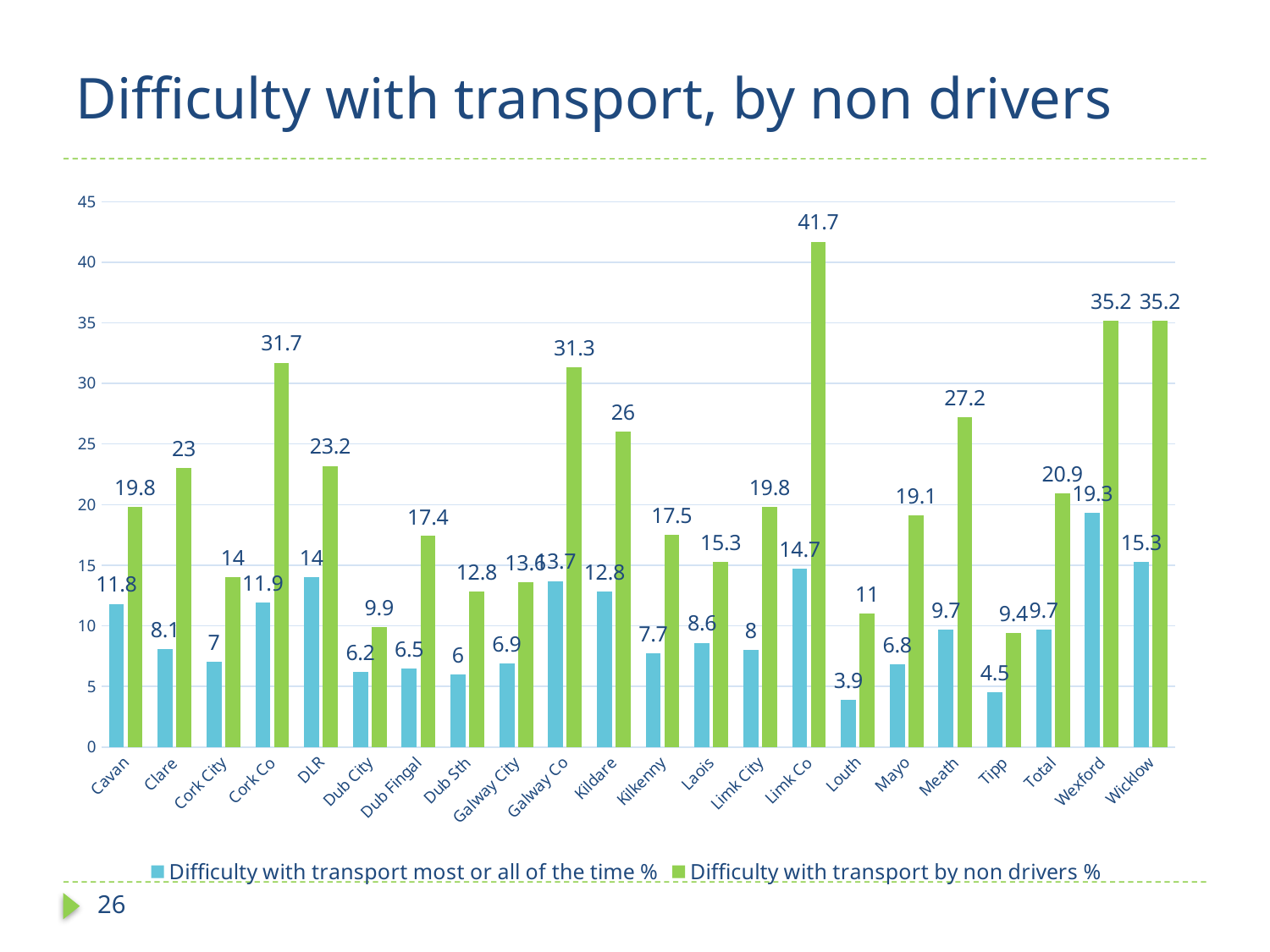
How many categories are shown on the x axis? 22 How many series does the legend list? 2 What is the value of 'Difficulty with transport most or all of the time %' for Louth? 3.9 What is the difference between the two series' values for Total? 11.2 What type of chart is shown on the slide? bar chart What is the title of the chart? Difficulty with transport, by non drivers Which is larger: 'Difficulty with transport by non drivers %' for Meath or for Kildare? Meath Which category has the highest value for 'Difficulty with transport by non drivers %'? Limk Co Which category has the lowest value for 'Difficulty with transport most or all of the time %'? Louth What is the value of 'Difficulty with transport by non drivers %' for Cork Co? 31.7 Which category has the highest value for 'Difficulty with transport most or all of the time %'? Wexford What is the value of 'Difficulty with transport by non drivers %' for Limk Co? 41.7